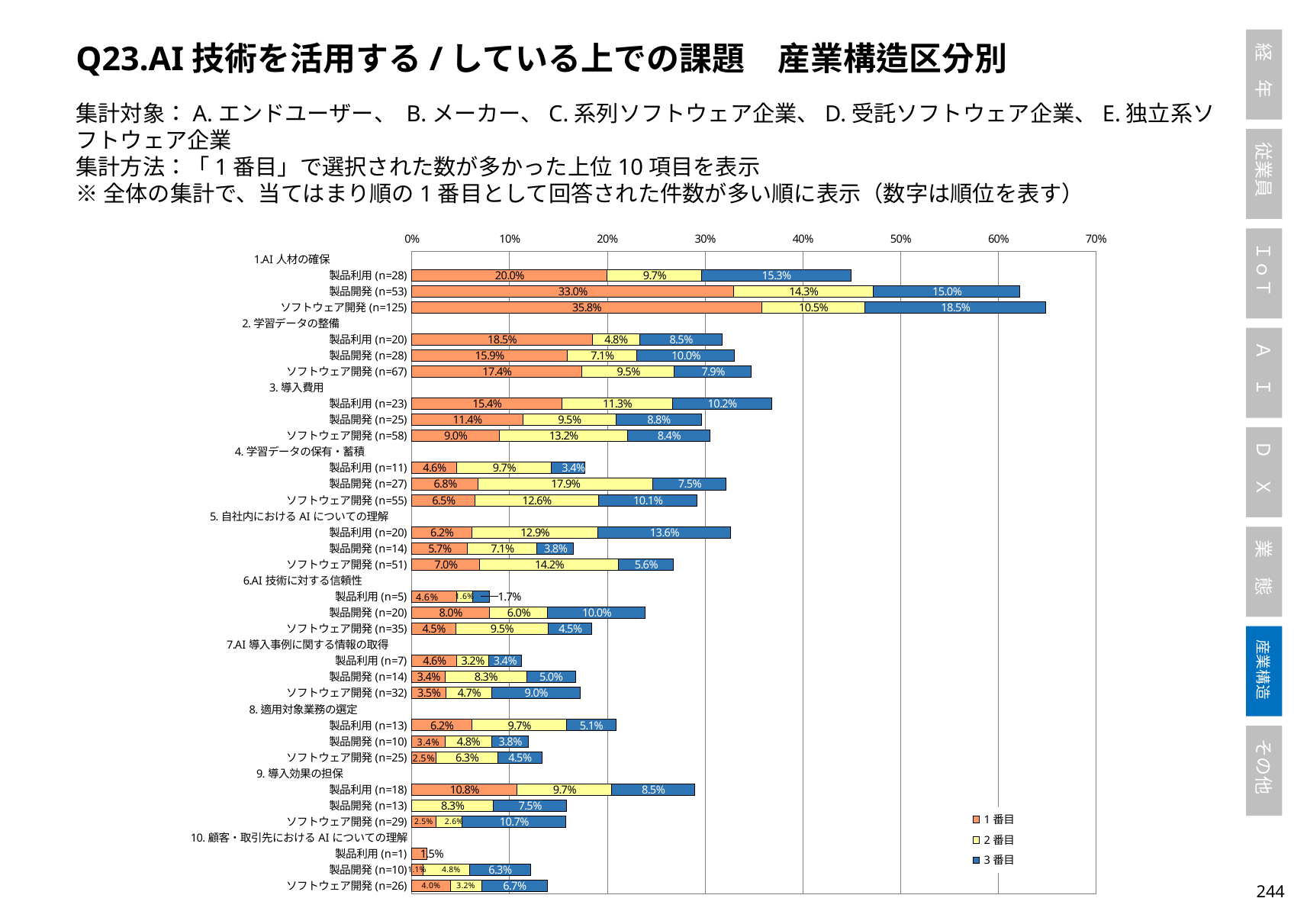
What is the total of the stacked bar for 製品利用 (n=28) under 1.AI 人材の確保? 45.0% What is the difference between the 1番目 values for ソフトウェア開発 (n=125) and 製品開発 (n=53) under 1.AI 人材の確保? 2.8 percentage points What is the 1番目 value for ソフトウェア開発 (n=125) under 1.AI 人材の確保? 35.8% What is the 3番目 value for 製品利用 (n=20) under 2. 学習データの整備? 8.5% Within 1.AI 人材の確保, which row has the highest 1番目 value? ソフトウェア開発 (n=125) Is the total stacked bar for 製品開発 (n=53) under 1.AI 人材の確保 greater or less than 60%? greater What are the three legend entries of the chart? 1 番目, 2 番目, 3 番目 How many series does the legend list? 3 Under 3. 導入費用, which has the larger 1番目 value: 製品利用 (n=23) or 製品開発 (n=25)? 製品利用 (n=23) What is the 2番目 value for 製品開発 (n=53) under 1.AI 人材の確保? 14.3% What kind of chart is shown on the slide? Stacked horizontal bar chart How many numbered challenge items are shown on the chart? 10